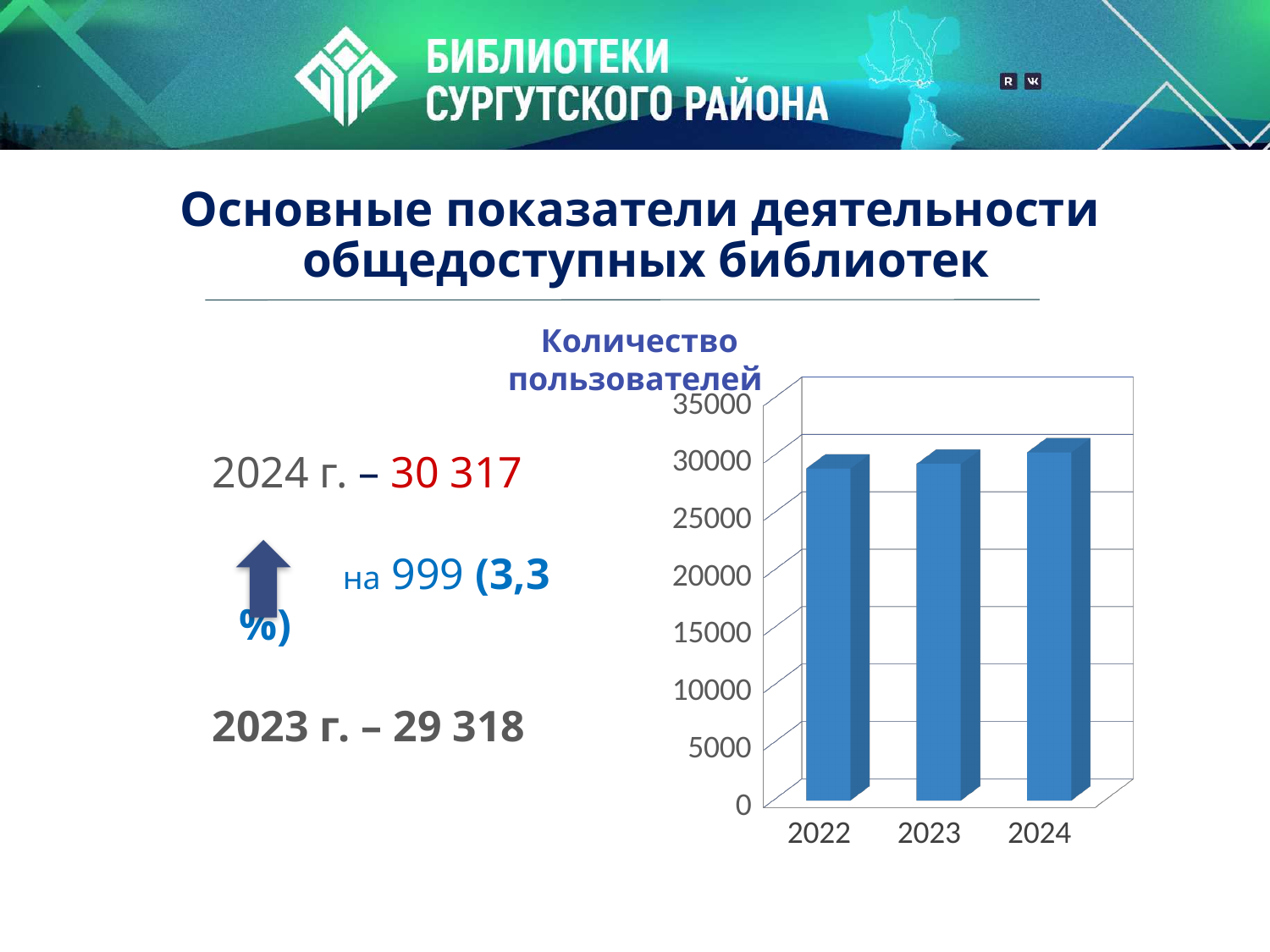
What is the title of the chart? Количество пользователей Which bar is taller, 2022 or 2024? 2024 How many years are shown on the x axis of the chart? 3 According to the text on the slide, what is the number of users in 2024? 30 317 Is the bar for 2023 greater or less than 20000? greater According to the text on the slide, what is the number of users in 2023? 29 318 What kind of chart is shown on the slide? bar chart Do the values rise or fall from 2022 to 2024? rise What colour are the bars in the chart? blue Is the bar for 2022 greater or less than 25000? greater Which year has the highest bar in the chart? 2024 Is the bar for 2024 greater or less than 35000? less